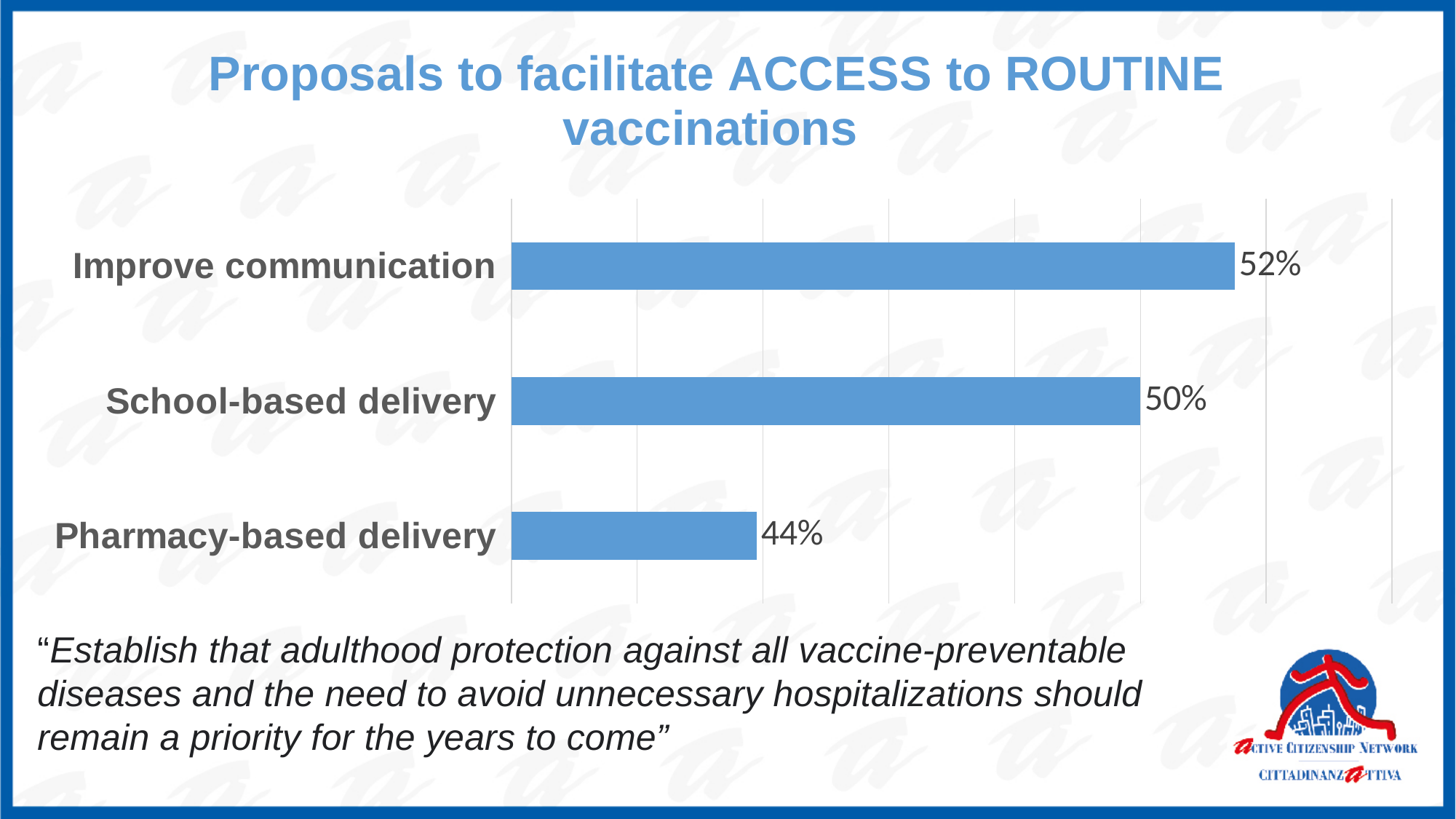
What is the difference between the values for Improve communication and Pharmacy-based delivery? 8% Which is larger, the value for School-based delivery or the value for Pharmacy-based delivery? School-based delivery What is the value for Improve communication? 52% What colour are the bars in the chart? Blue What is the value for School-based delivery? 50% What is the value for Pharmacy-based delivery? 44% How many proposals are shown in the chart? 3 Which proposal has the lowest value? Pharmacy-based delivery What is the difference between the values for School-based delivery and Pharmacy-based delivery? 6% Which proposal has the highest value? Improve communication What kind of chart is shown on the slide? Bar chart What is the title of the slide containing the chart? Proposals to facilitate ACCESS to ROUTINE vaccinations